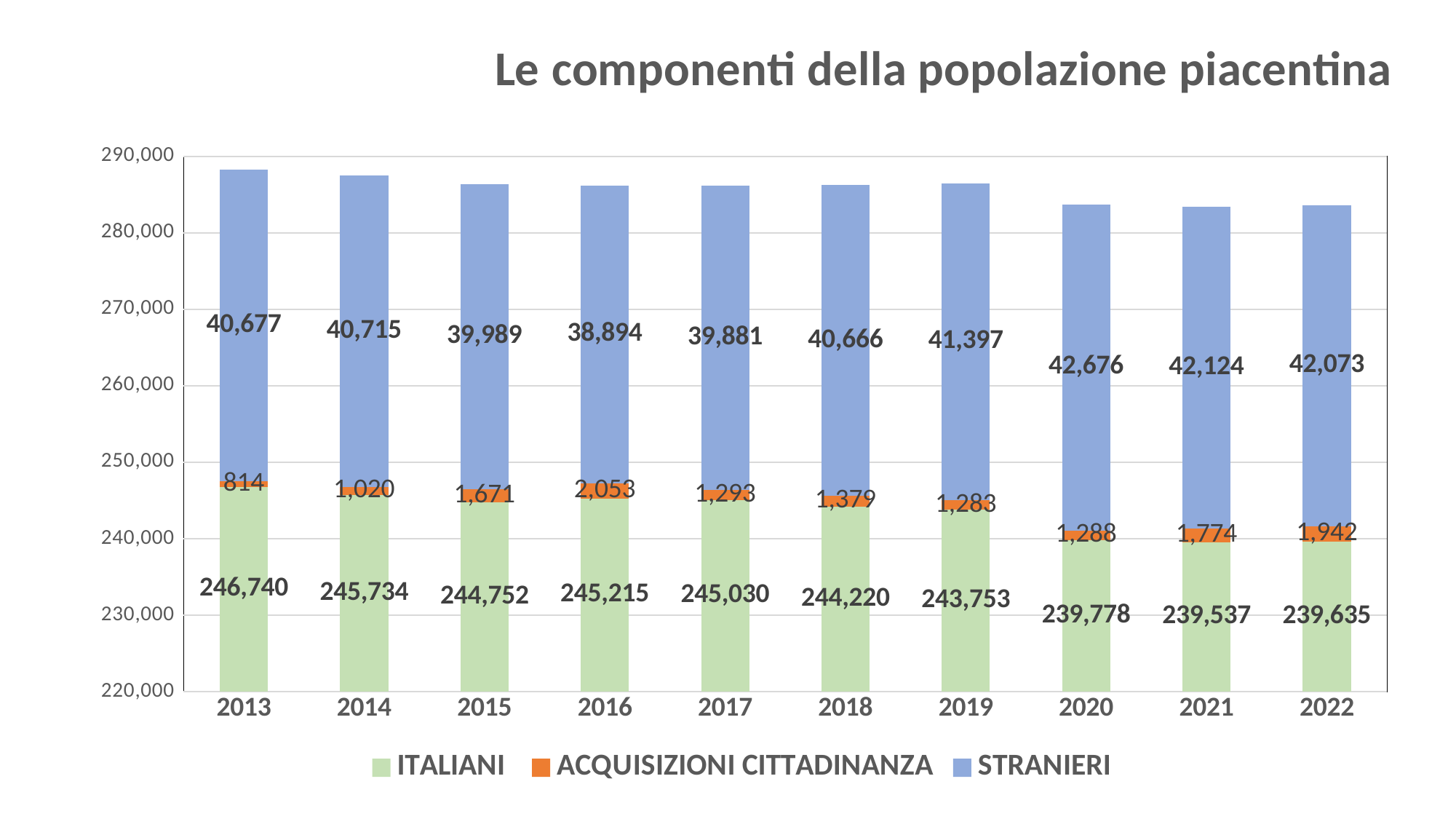
In which year is the STRANIERI value the lowest? 2016 What kind of chart is shown? Stacked bar chart Which is larger, the ITALIANI value in 2019 or in 2020? 2019 What is the total of the stacked bar for 2022? 283,650 What is the difference between the STRANIERI values in 2022 and 2013? 1,396 In which year is the ITALIANI value the highest? 2013 In which year is the ACQUISIZIONI CITTADINANZA value the lowest? 2013 What is the value for ACQUISIZIONI CITTADINANZA in 2016? 2,053 How many series does the legend list? 3 What is the value for ITALIANI in 2013? 246,740 How many years are shown on the x axis? 10 What is the value for STRANIERI in 2020? 42,676